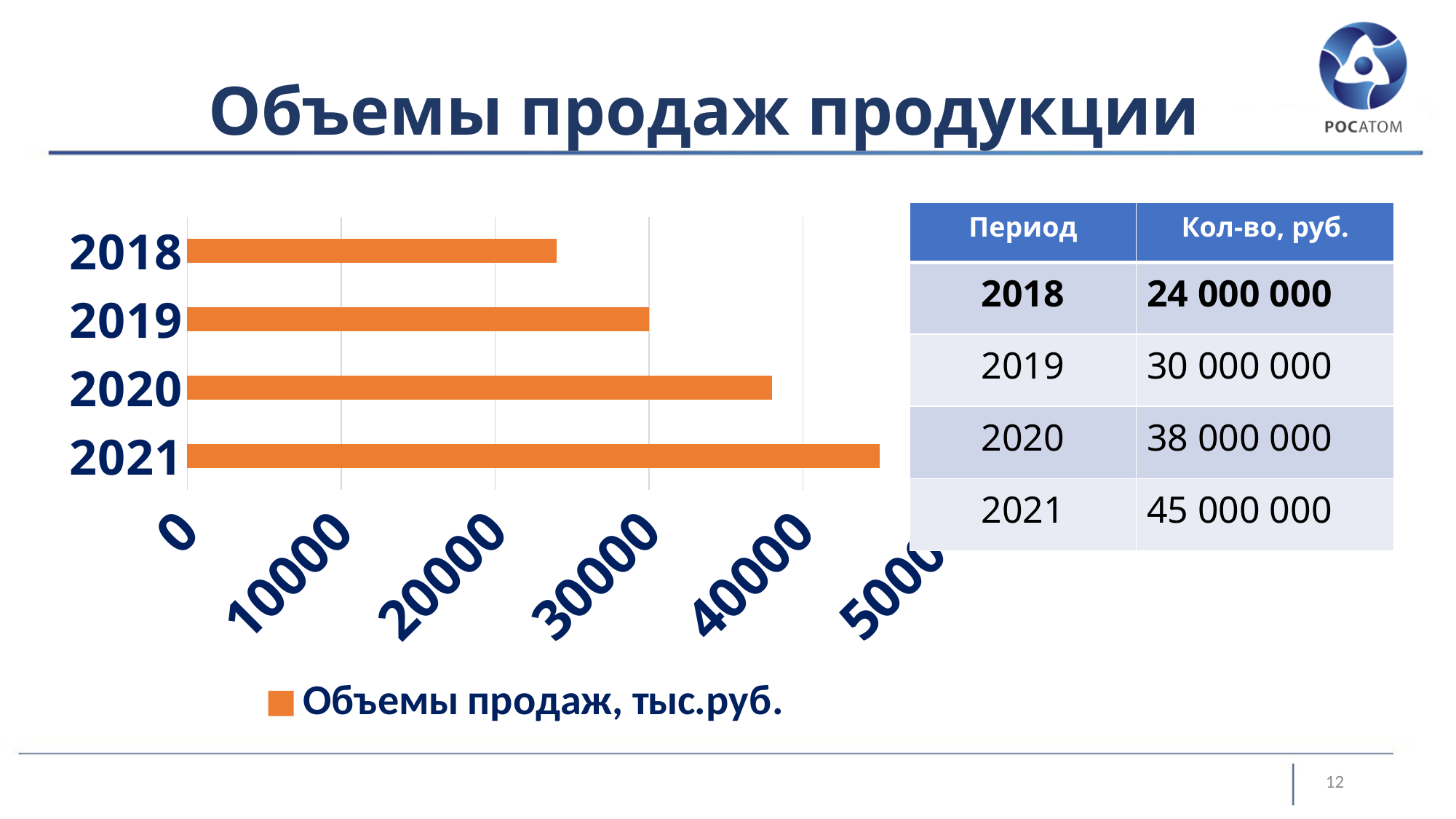
How many series does the chart legend list? 1 What kind of chart is shown on the slide? bar chart Which bar is longer in the chart, 2019 or 2020? 2020 Which year has the shortest bar in the chart? 2018 Which year has the longest bar in the chart? 2021 Do the sales volumes in the bar chart rise or fall from 2018 to 2021? rise How many years (categories) are plotted in the bar chart? 4 Is the value for 2020 in the bar chart greater or less than 30000? greater Is the value for 2018 in the bar chart greater or less than 30000? less Is the value for 2018 in the bar chart greater or less than 20000? greater What is the legend entry of the series in the bar chart? Объемы продаж, тыс.руб.